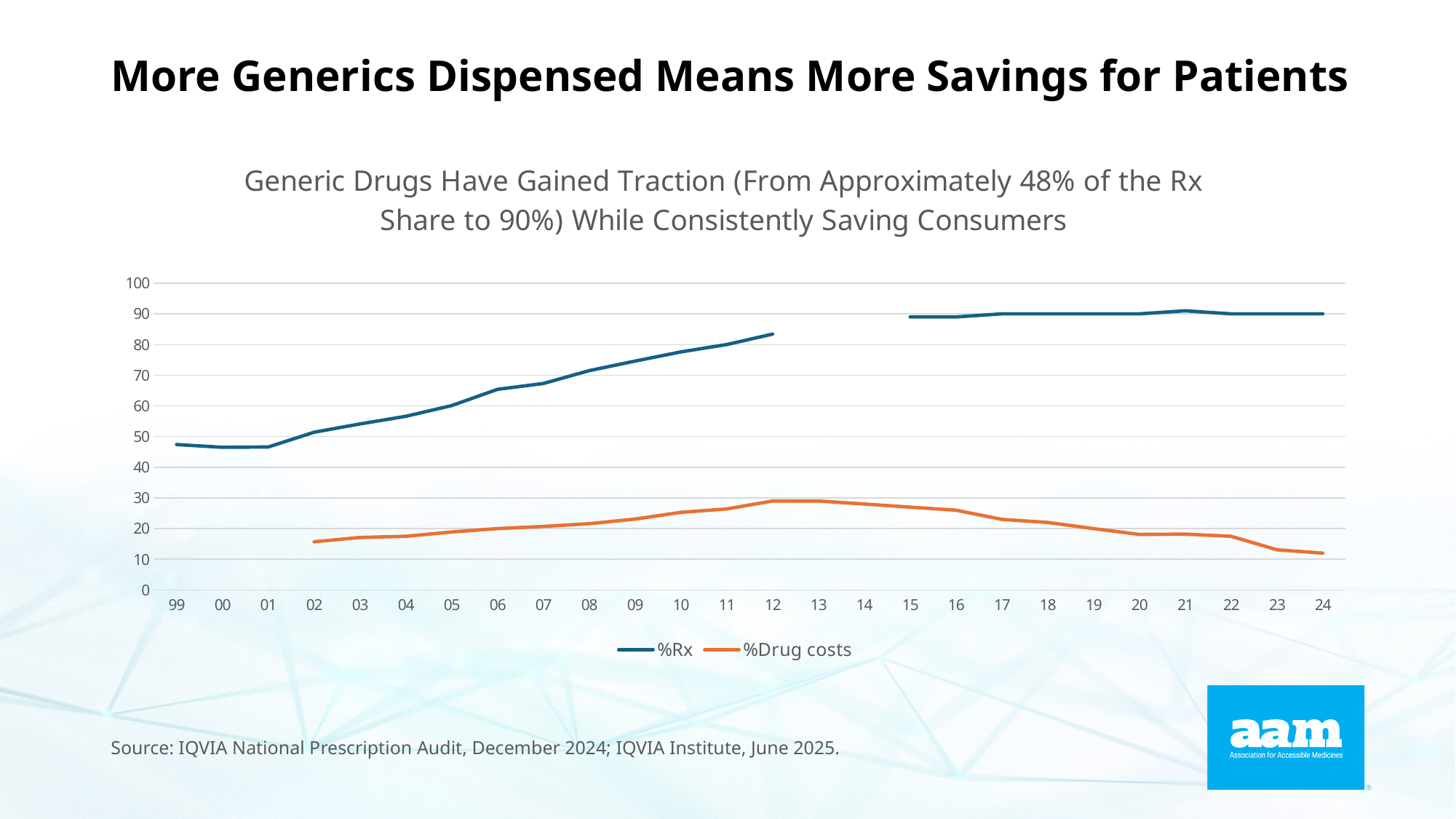
Is the value for %Rx in 06 greater or less than 60? greater In 12, which series has the larger value, %Rx or %Drug costs? %Rx Does the %Rx line rise or fall from 99 to 12? rise How many series does the legend list? 2 How many year labels are shown on the x axis? 26 Does the %Drug costs line rise or fall from 13 to 24? fall Is the value for %Drug costs in 02 greater or less than 20? less What kind of chart is shown on the slide? line chart What are the two series named in the legend? %Rx and %Drug costs Is the value for %Drug costs in 24 greater or less than 20? less